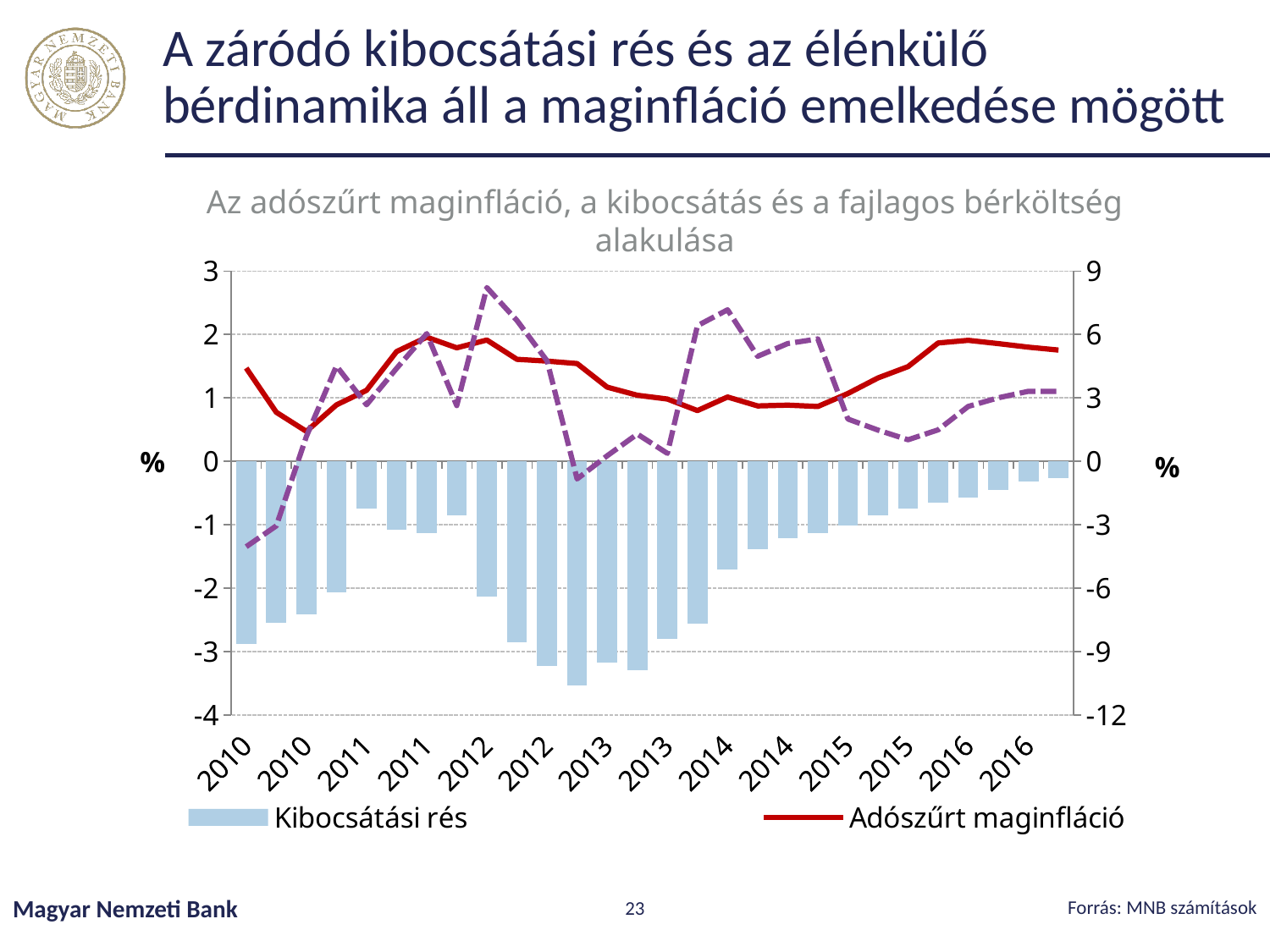
Do the Kibocsátási rés bars rise or fall from 2013 to 2016? rise What is the title of the chart? Az adószűrt maginfláció, a kibocsátás és a fajlagos bérköltség alakulása Is the Adószűrt maginfláció line above or below 0 at the end of 2016? above Is the value of the first Kibocsátási rés bar (2010) greater or less than -2 on the left axis? less In which year does the Kibocsátási rés reach its lowest (most negative) value? 2012 Which series is shown as bars in the chart? Kibocsátási rés What kind of chart is shown on the slide? A combined bar and line chart In which year is the Kibocsátási rés bar closest to zero (highest)? 2016 Is the value of the last Kibocsátási rés bar (2016) greater or less than -1 on the left axis? greater Are all the Kibocsátási rés bars negative or positive? negative Is the Kibocsátási rés bar in the first half of 2010 larger or smaller than the bar in the first half of 2016? smaller How many series does the legend list? 2